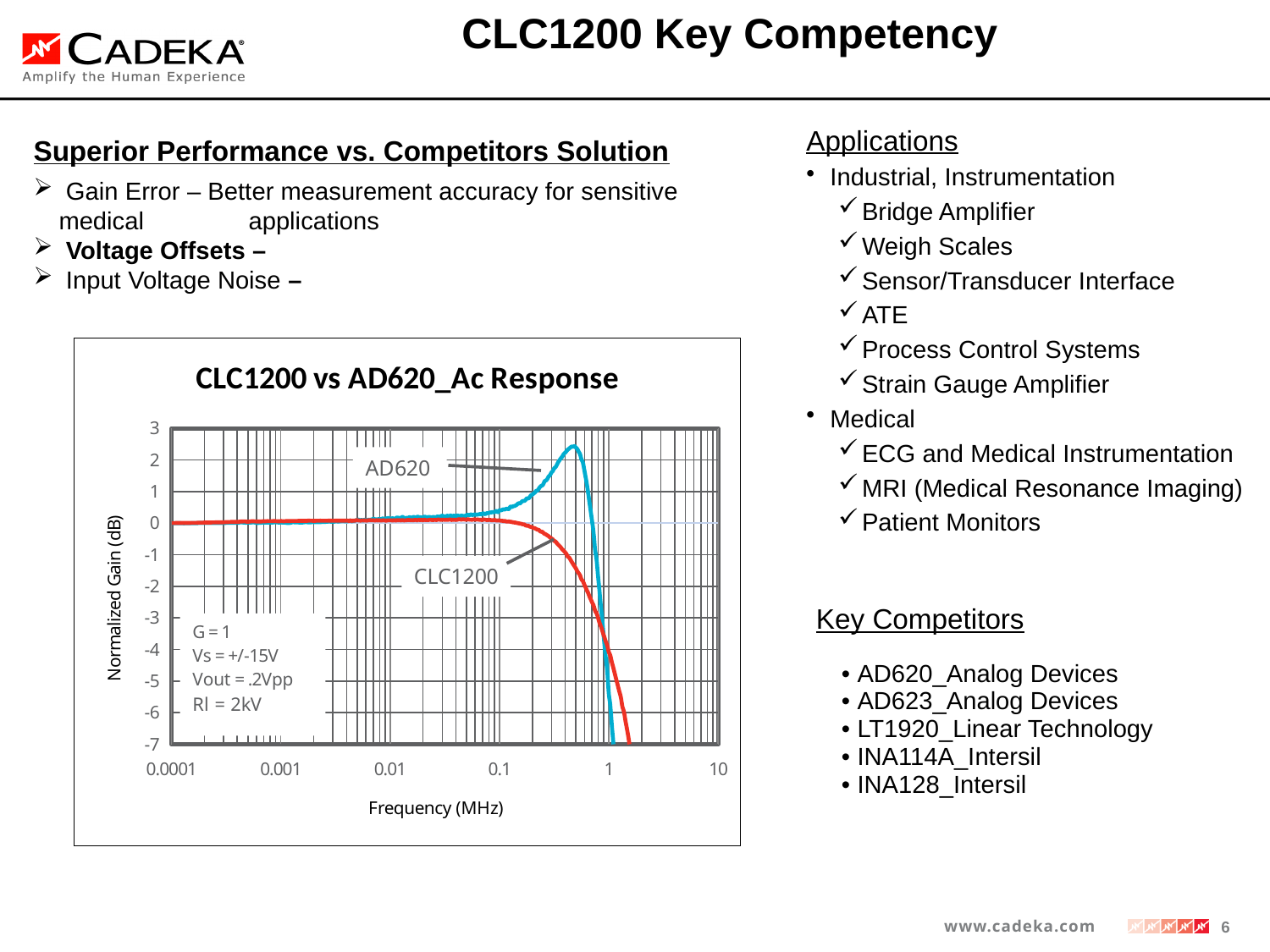
What is the label of the y-axis of the chart? Normalized Gain (dB) Do both curves rise or fall as frequency increases beyond 1 MHz? fall How many labeled tick values are shown on the x-axis? 6 What is the title of the chart? CLC1200 vs AD620_Ac Response Which series drops to -7 dB at the lower frequency? AD620 At 0.5 MHz, which series has the higher normalized gain, AD620 or CLC1200? AD620 What is the lowest value shown on the y-axis? -7 How many series are plotted in the chart? 2 Is the peak value of the AD620 curve greater or less than 2? greater What kind of chart is shown on the slide? line chart Which series rises above 0 dB before rolling off? AD620 Is the value of the CLC1200 curve at 1 MHz greater or less than -3? less